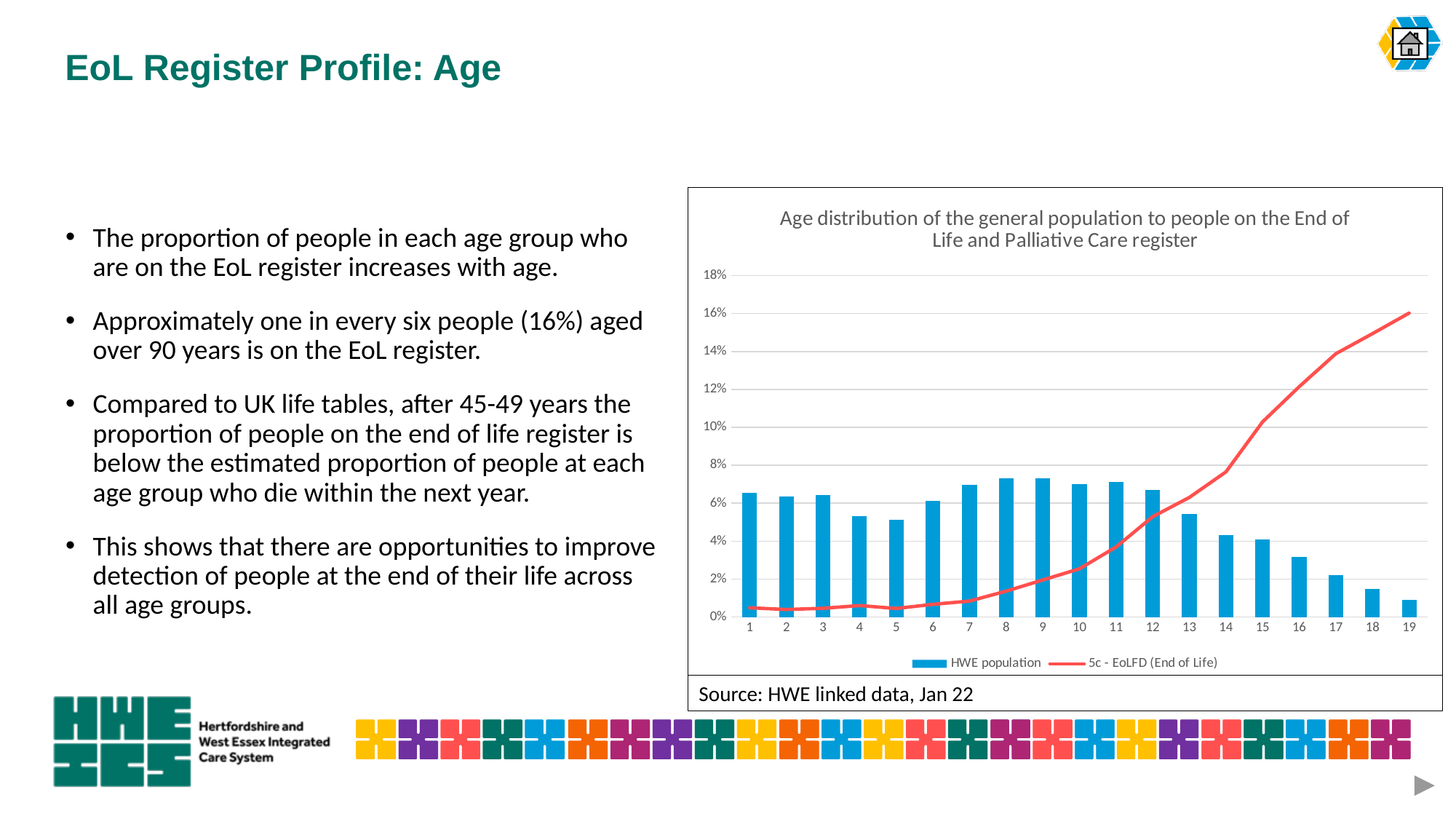
Is the HWE population value for category 8 greater or less than 6%? greater Does the 5c - EoLFD (End of Life) line rise or fall as the categories go from 1 to 19? Rises How many categories are shown along the x axis of the chart? 19 What is the title of the chart? Age distribution of the general population to people on the End of Life and Palliative Care register Which series is drawn as a red line in the chart? 5c - EoLFD (End of Life) What type of chart is shown on the slide? Combined bar and line chart Is the HWE population value for category 19 greater or less than 2%? less At category 17, which is larger: the HWE population bar or the 5c - EoLFD (End of Life) line? 5c - EoLFD (End of Life) Is the 5c - EoLFD (End of Life) value for category 19 greater or less than 14%? greater Which category has the lowest HWE population bar? 19 At which category does the 5c - EoLFD (End of Life) line reach its highest value? 19 How many series does the chart legend list? 2